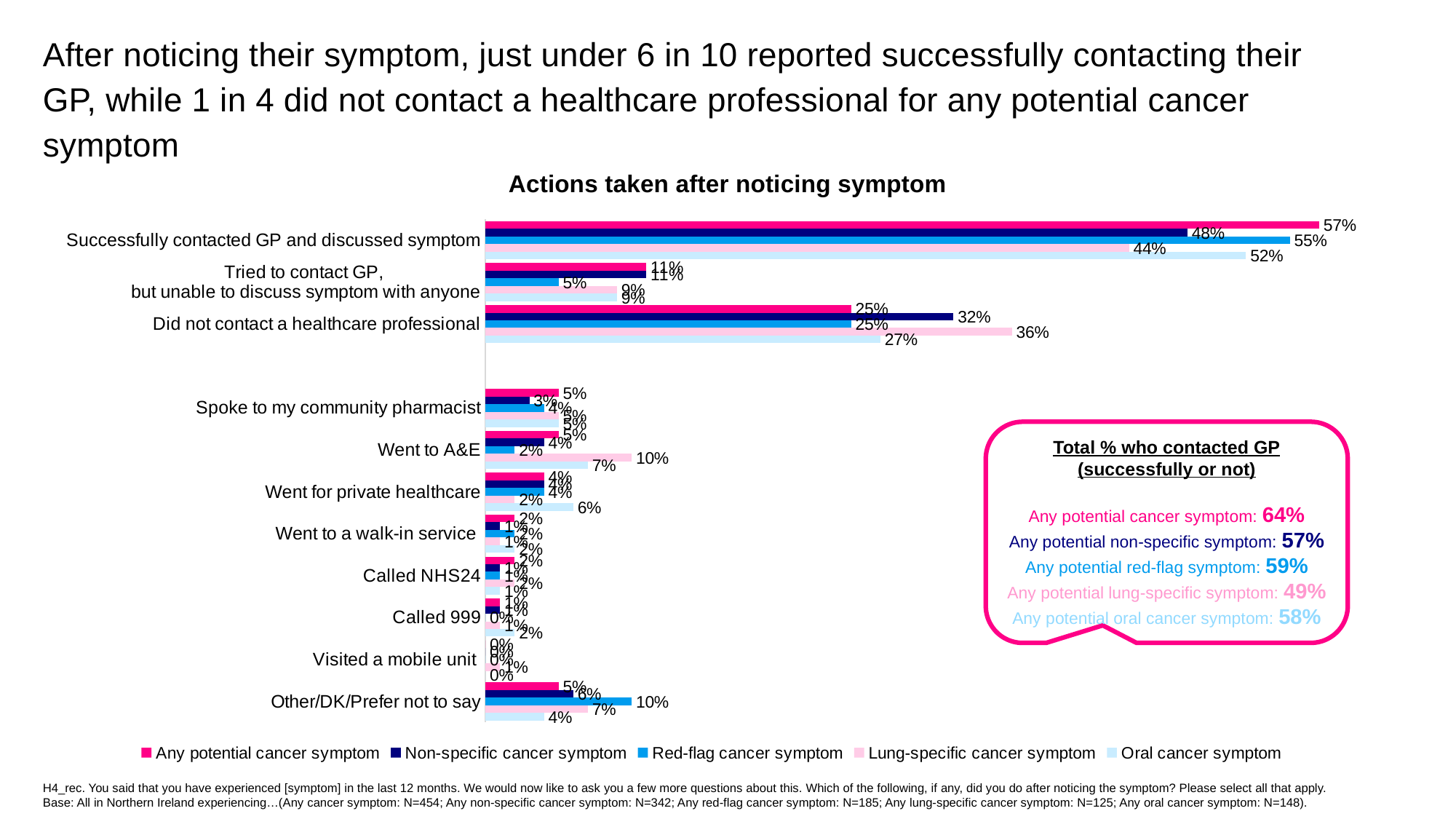
Which series has the lowest value for 'Successfully contacted GP and discussed symptom'? Lung-specific cancer symptom What type of chart is shown on the slide? bar chart What is the value for 'Lung-specific cancer symptom' for 'Did not contact a healthcare professional'? 36% What is the value for 'Lung-specific cancer symptom' for 'Went to A&E'? 10% How many series does the legend list? 5 For 'Did not contact a healthcare professional', which is larger: the 'Lung-specific cancer symptom' value or the 'Oral cancer symptom' value? Lung-specific cancer symptom What is the value for 'Red-flag cancer symptom' for 'Other/DK/Prefer not to say'? 10% What is the difference between the 'Any potential cancer symptom' and 'Lung-specific cancer symptom' values for 'Successfully contacted GP and discussed symptom'? 13% Which series has the highest value for 'Successfully contacted GP and discussed symptom'? Any potential cancer symptom What is the title of the chart? Actions taken after noticing symptom What is the value for 'Non-specific cancer symptom' for 'Did not contact a healthcare professional'? 32% What is the value for 'Any potential cancer symptom' for 'Successfully contacted GP and discussed symptom'? 57%